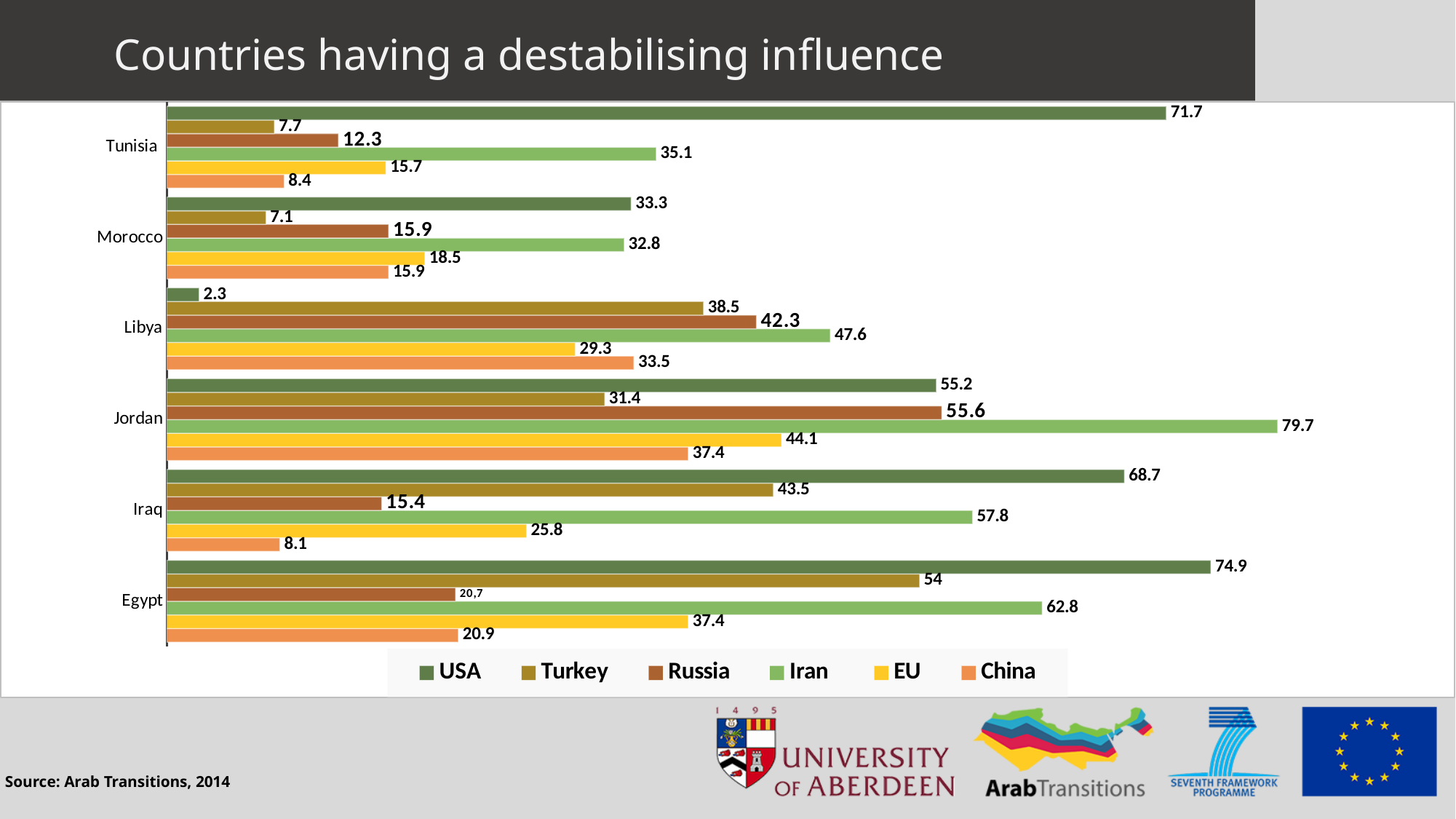
What is the difference between the USA and Turkey values for Tunisia? 64 What is the value for China in Iraq? 8.1 For Iraq, which is larger: the value for USA or the value for Iran? USA What is the difference between the Iran and EU values for Jordan? 35.6 How many countries are shown on the chart? 6 Which country has the highest value for USA? Egypt What is the value for Turkey in Egypt? 54 Which series has the highest value for Libya? Iran Which country has the lowest value for USA? Libya What is the value for USA in Tunisia? 71.7 What is the value for Iran in Jordan? 79.7 How many series does the legend list? 6